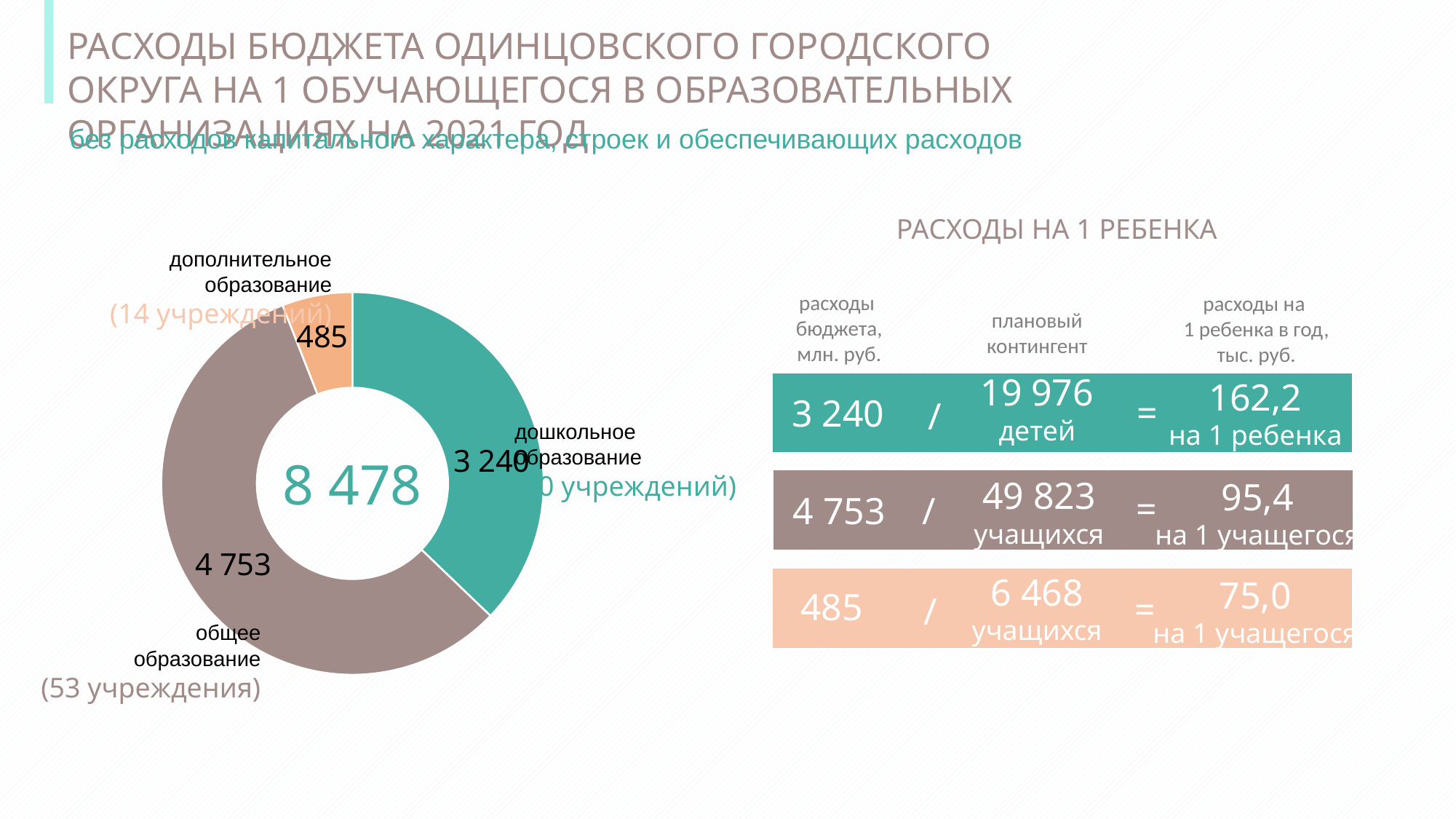
What value is shown for the "общее образование" segment of the donut chart? 4 753 Which segment of the donut chart has the largest value? общее образование What type of chart is shown on the left of the slide? Donut (pie) chart How many segments does the donut chart have? 3 What is the title of the table to the right of the donut chart? РАСХОДЫ НА 1 РЕБЕНКА In the donut chart, which is larger: the value for "дошкольное образование" or for "дополнительное образование"? дошкольное образование What value is shown for the "дошкольное образование" segment of the donut chart? 3 240 What is the difference between the values for "общее образование" and "дошкольное образование" in the donut chart? 1 513 Which segment of the donut chart has the smallest value? дополнительное образование What colour is the "дошкольное образование" segment of the donut chart? Teal (green) What total is shown in the centre of the donut chart? 8 478 What value is shown for the "дополнительное образование" segment of the donut chart? 485